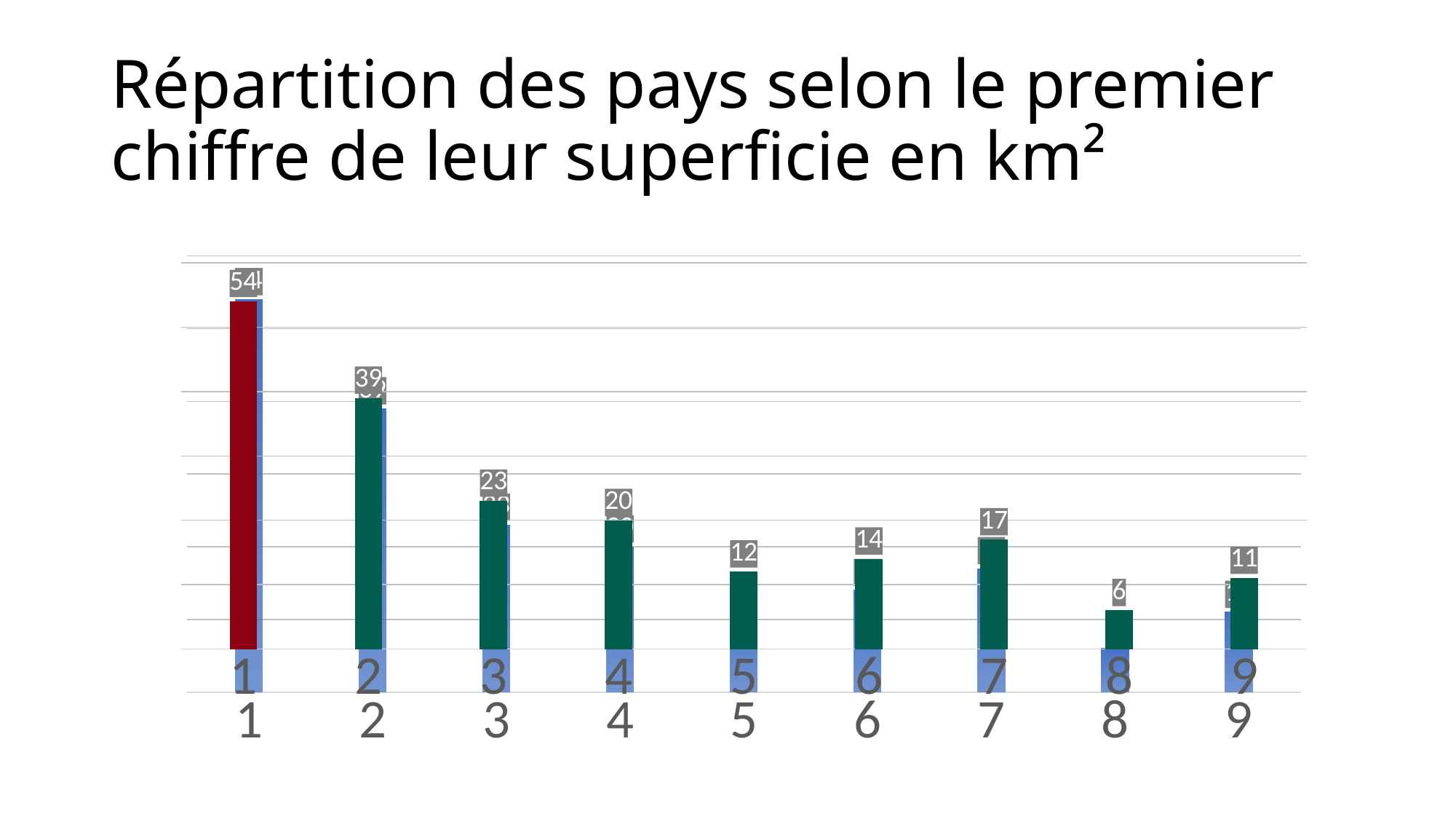
What is the difference between the values for category 1 and category 2? 15 What colour is the bar for category 1? dark red Do the values generally rise or fall from category 1 to category 9? fall How many categories are shown on the x axis of the chart? 9 Which has the larger value, category 5 or category 6? 6 What kind of chart is shown on the slide? bar chart Which category has the lowest value in the chart? 8 What is the value shown for category 9? 11 What is the value shown for category 2? 39 Which category has the highest value in the chart? 1 What is the difference between the values for category 7 and category 8? 11 What is the value shown for category 5? 12